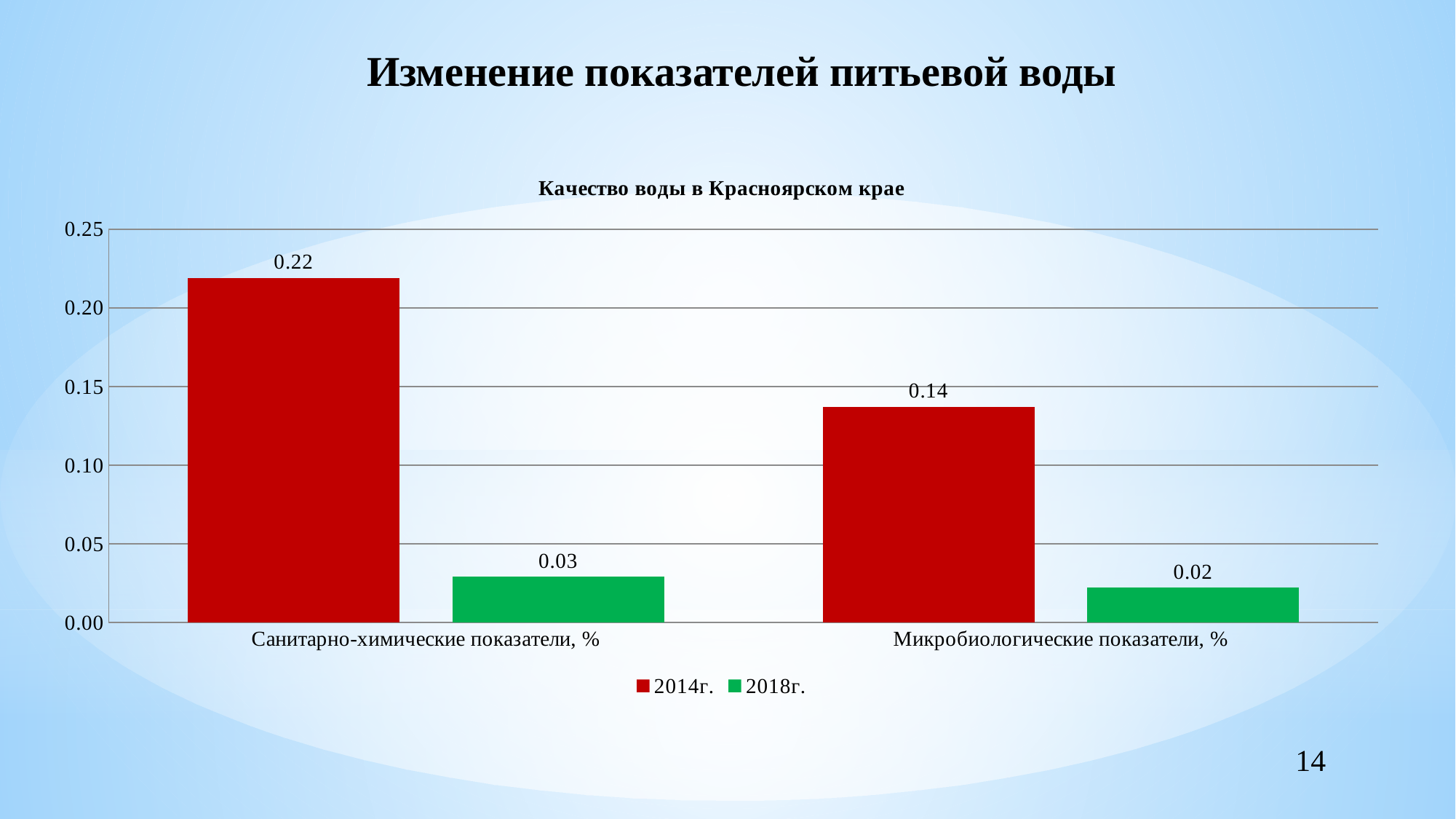
What is the difference between the 2014г. and 2018г. values for Микробиологические показатели, %? 0.12 Which is larger: the 2014г. value for Микробиологические показатели, % or the 2018г. value for Санитарно-химические показатели, %? 2014г. value for Микробиологические показатели, % What is the value for 2018г. in the Микробиологические показатели, % category? 0.02 What is the value for 2018г. in the Санитарно-химические показатели, % category? 0.03 What is the title of the chart? Качество воды в Красноярском крае How many series does the legend list? 2 What is the value for 2014г. in the Санитарно-химические показатели, % category? 0.22 Which category has the highest value for 2014г.? Санитарно-химические показатели, % What is the difference between the 2014г. and 2018г. values for Санитарно-химические показатели, %? 0.19 What is the value for 2014г. in the Микробиологические показатели, % category? 0.14 Which category has the lowest value for 2018г.? Микробиологические показатели, % What kind of chart is shown on the slide? Bar chart